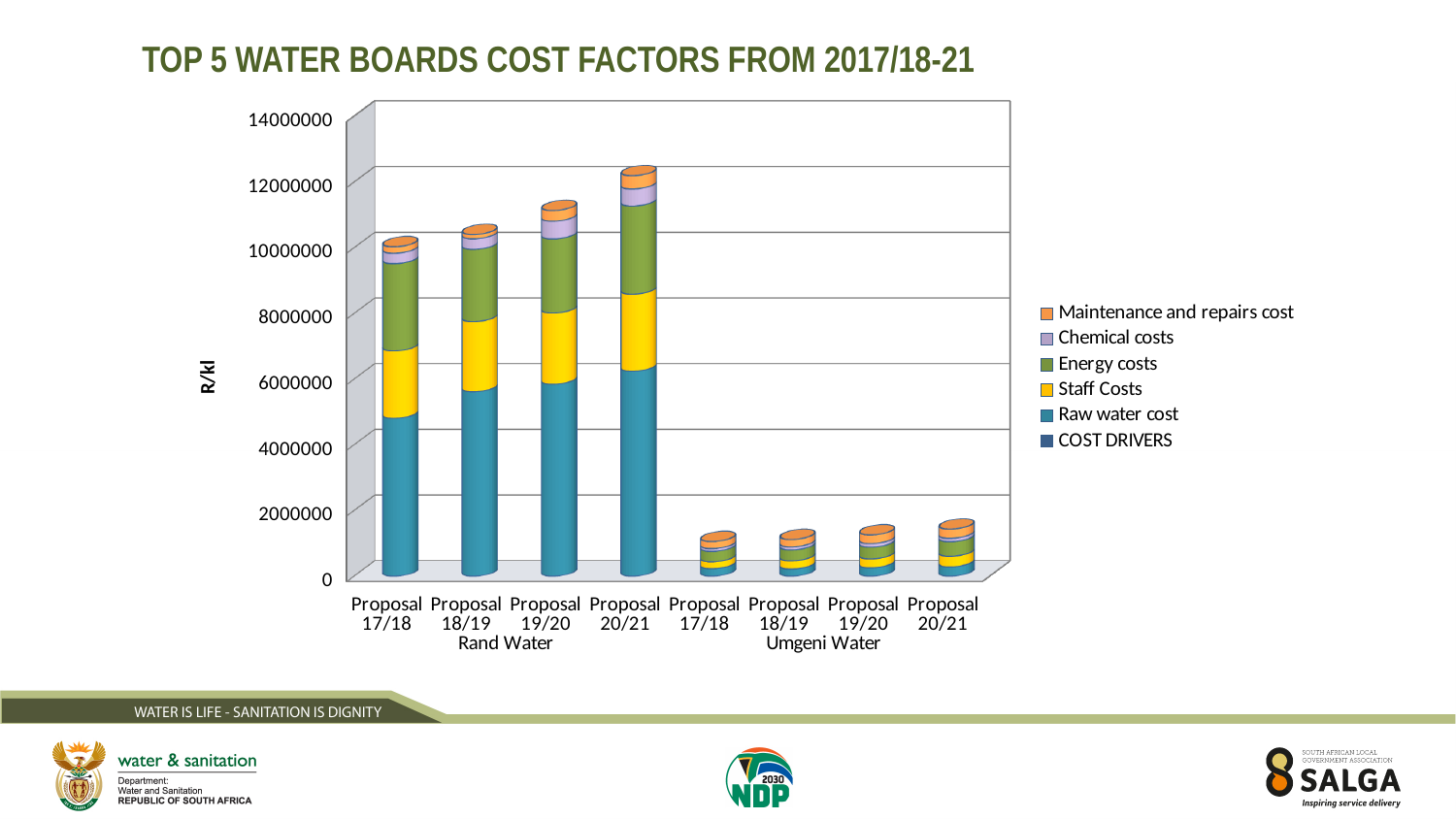
What is the title of the chart? TOP 5 WATER BOARDS COST FACTORS FROM 2017/18-21 What is the label on the vertical axis? R/kl Do the Rand Water totals rise or fall from Proposal 17/18 to Proposal 20/21? rise Which water board has the larger total cost for Proposal 20/21, Rand Water or Umgeni Water? Rand Water Which bar has the highest total cost? Rand Water Proposal 20/21 Is the total for Rand Water Proposal 19/20 greater or less than 10000000? greater Is the total for Rand Water Proposal 18/19 greater or less than 8000000? greater How many bars (proposals) are plotted in the chart? 8 Is the total for Umgeni Water Proposal 20/21 greater or less than 2000000? less What kind of chart is shown on the slide? Stacked bar chart How many series does the legend list? 6